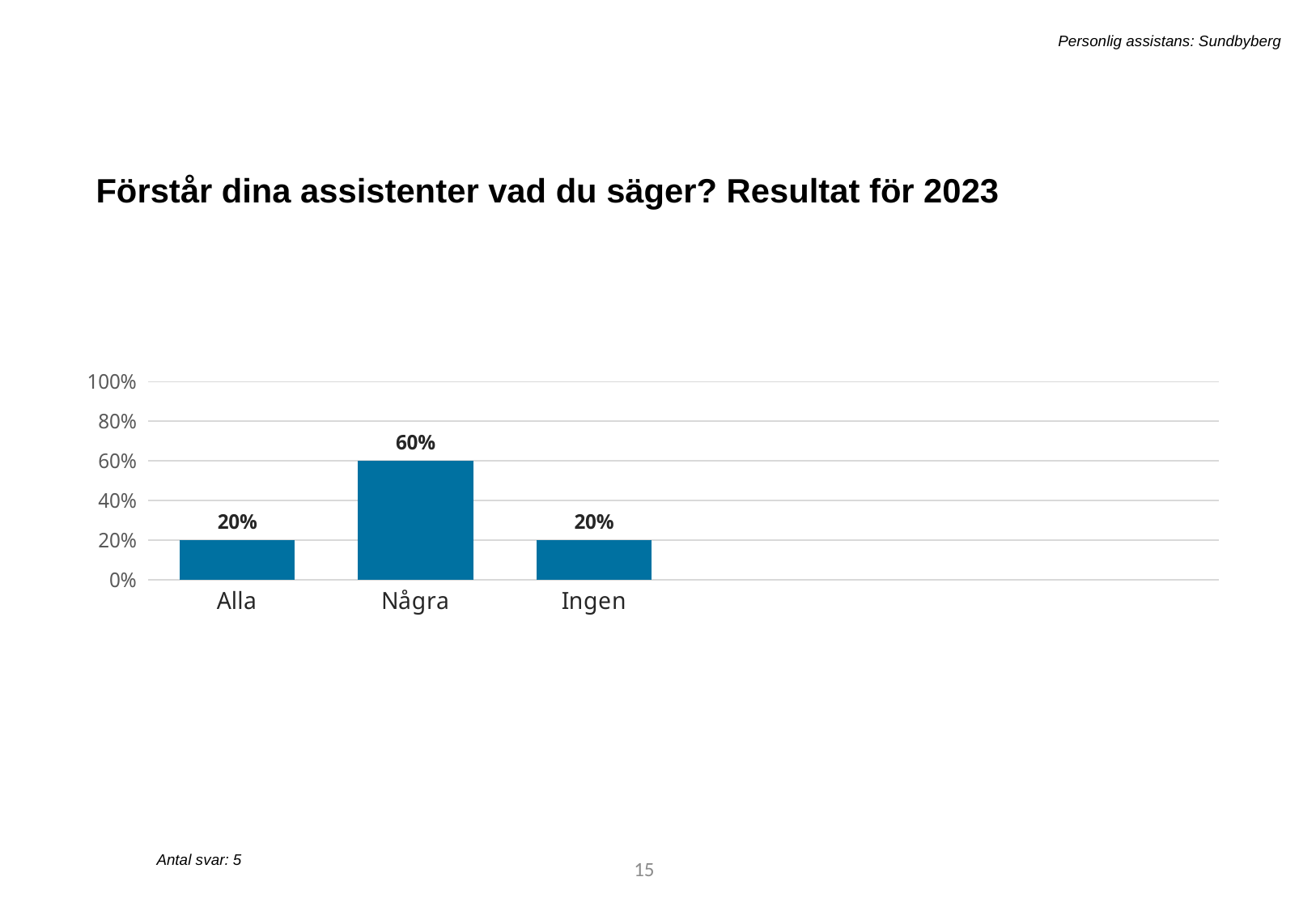
What is the value for Alla? 20% What is the value for Ingen? 20% Is the value for Alla greater or less than 40%? less Is the value for Några greater or less than 40%? greater How many categories are shown on the x axis? 3 Which category has the highest value? Några What is the value for Några? 60% How many responses (Antal svar) does the slide report? 5 What is the title of the slide? Förstår dina assistenter vad du säger? Resultat för 2023 What is the difference between the values for Några and Alla? 40% Which is larger, the value for Några or the value for Ingen? Några What kind of chart is shown on the slide? bar chart